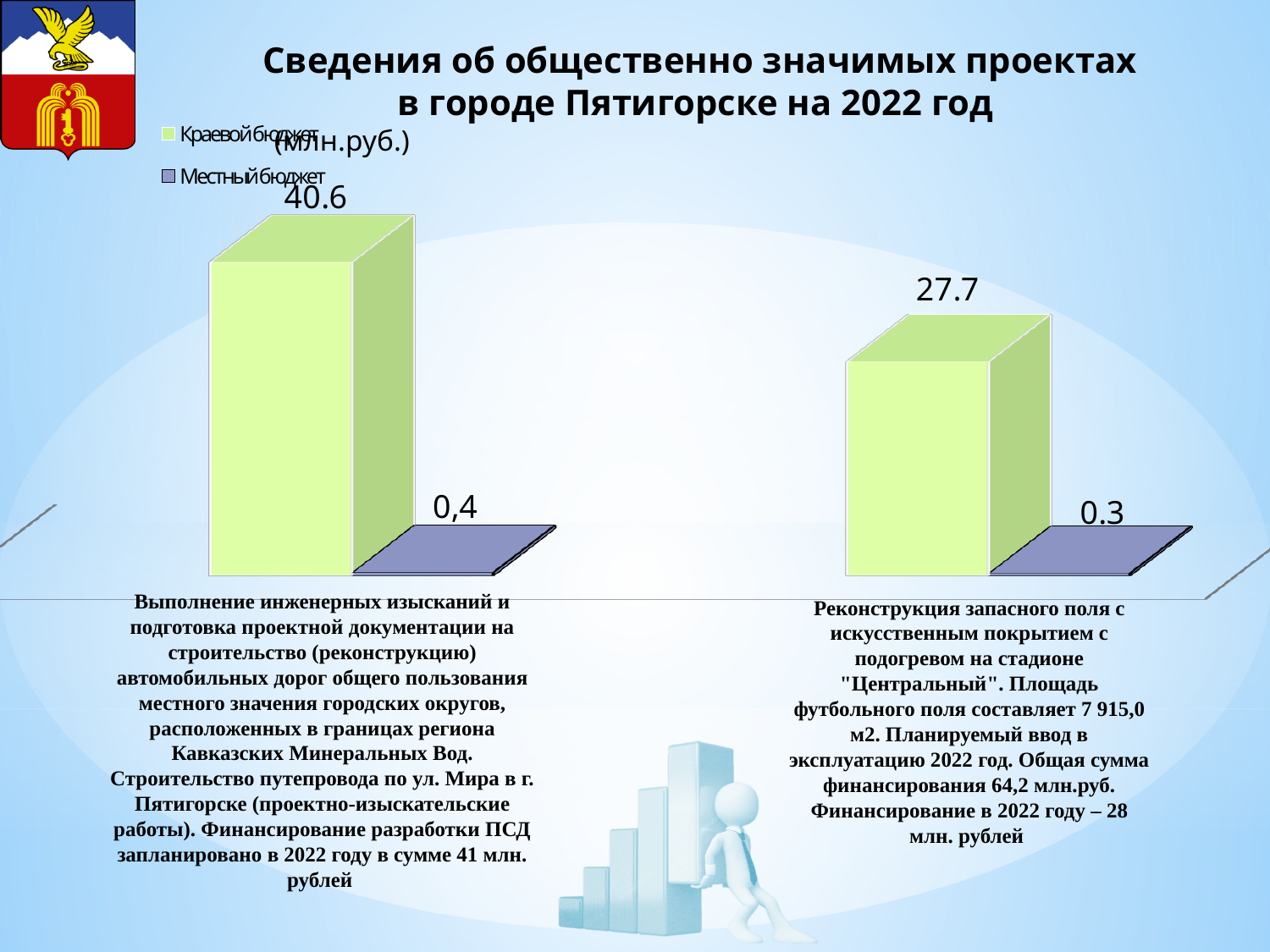
How many series does the legend list? 2 What is the value of the Местный бюджет bar for the stadium reserve field reconstruction project (the right category)? 0.3 What kind of chart is shown on the slide? Bar chart What is the value of the Краевой бюджет bar for the reconstruction of the reserve field at the "Центральный" stadium (the right category)? 27.7 How many categories (projects) are shown in the chart? 2 What is the value of the Местный бюджет bar for the road design documentation project (the left category)? 0,4 What is the value of the Краевой бюджет bar for the project on engineering surveys and design documentation for roads (the left category)? 40.6 What is the difference between the Краевой бюджет values of the two projects (40.6 and 27.7)? 12.9 Which series is shown in light green in the legend? Краевой бюджет Which category has the highest Краевой бюджет value? Выполнение инженерных изысканий и подготовка проектной документации (the left category) Which is larger: the Краевой бюджет value for the road design project or for the stadium field reconstruction project? The road design project (40.6) In what units are the chart values given, according to the subtitle? млн.руб.